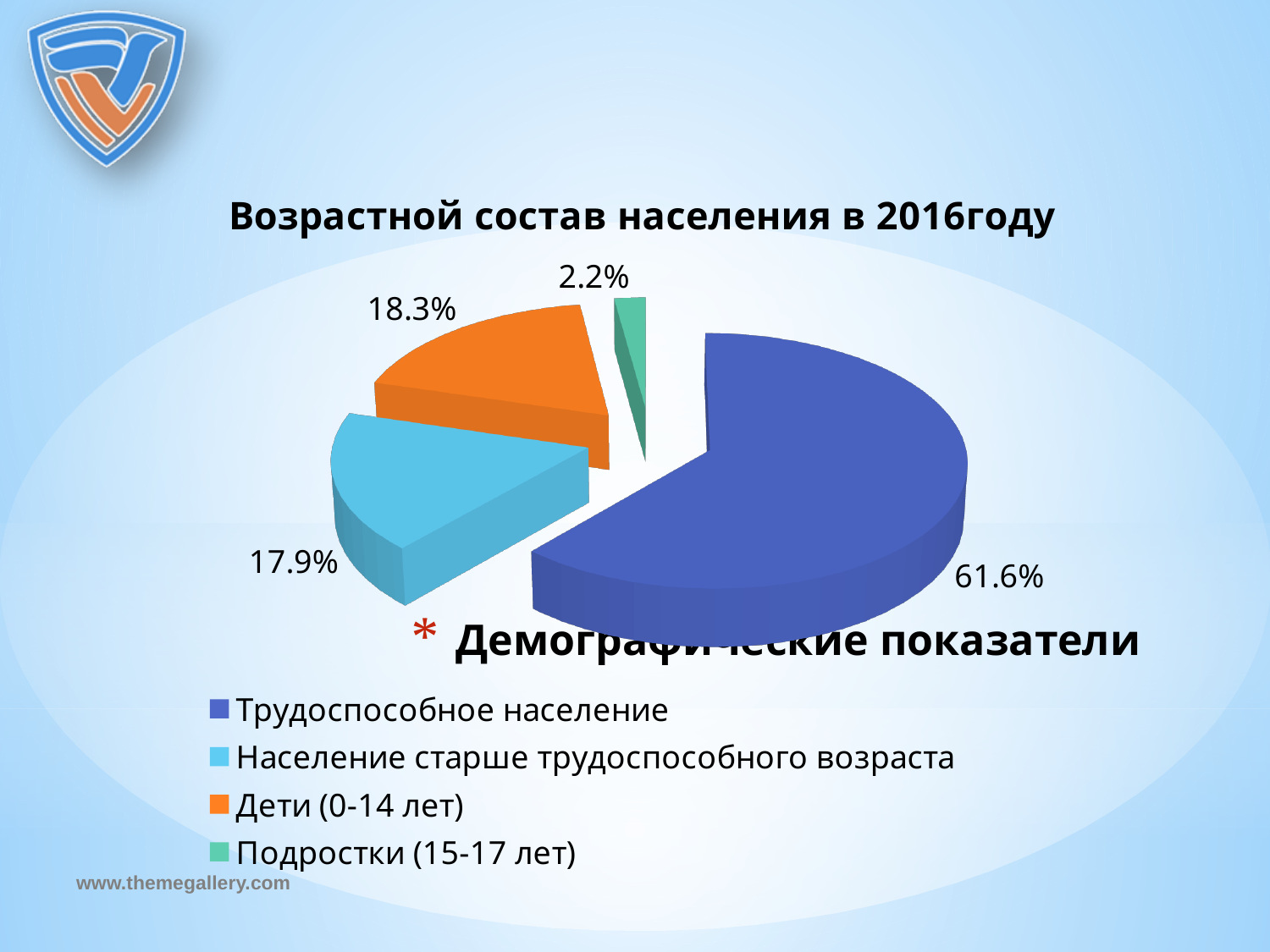
Which category has the largest share of the pie? Трудоспособное население What kind of chart is shown on the slide? Pie chart Which colour represents Дети (0-14 лет) in the chart? Orange What share of the population is Трудоспособное население? 61.6% What share of the population is Подростки (15-17 лет)? 2.2% What share of the population is Дети (0-14 лет)? 18.3% What share of the population is Население старше трудоспособного возраста? 17.9% What is the difference in percentage points between Трудоспособное население and Дети (0-14 лет)? 43.3 What is the title of the chart? Возрастной состав населения в 2016году How many categories does the pie chart show? 4 What is the difference in percentage points between Дети (0-14 лет) and Население старше трудоспособного возраста? 0.4 Which category has the smallest share of the pie? Подростки (15-17 лет)